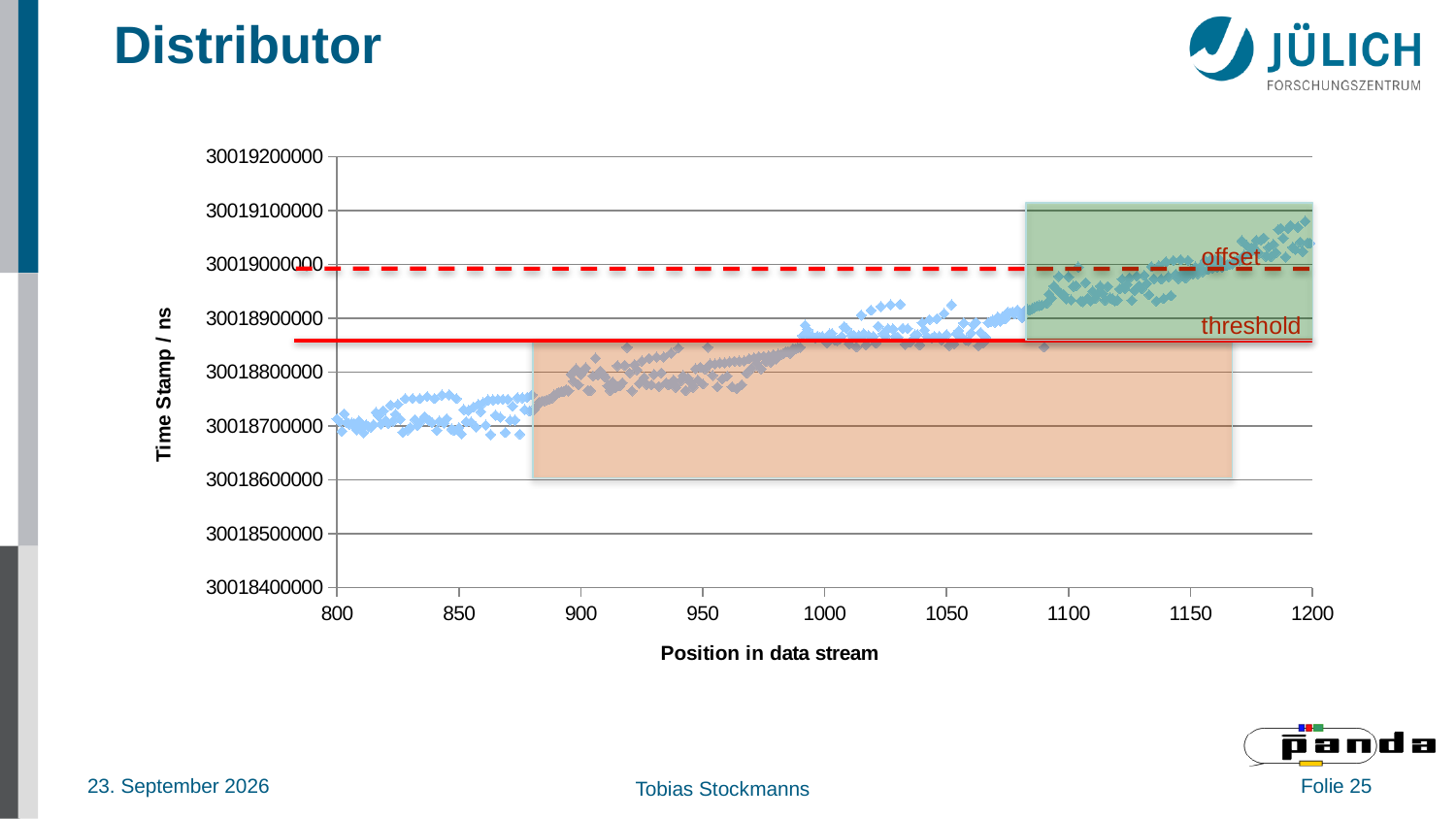
What is the title of the y axis of the chart? Time Stamp / ns Do the plotted time stamp values rise or fall as the position in the data stream increases from 800 to 1200? rise Is the time stamp value at position 1000 greater or less than 30018800000? greater What kind of chart is shown on the slide? scatter chart How many tick labels are shown on the x axis of the chart? 9 Is the time stamp value at position 1200 greater or less than 30019000000? greater What is the lowest value shown on the y axis of the chart? 30018400000 Which has the larger time stamp value: the point at position 850 or the point at position 1150? position 1150 What is the highest value shown on the x axis of the chart? 1200 Is the time stamp value at position 800 greater or less than 30018800000? less